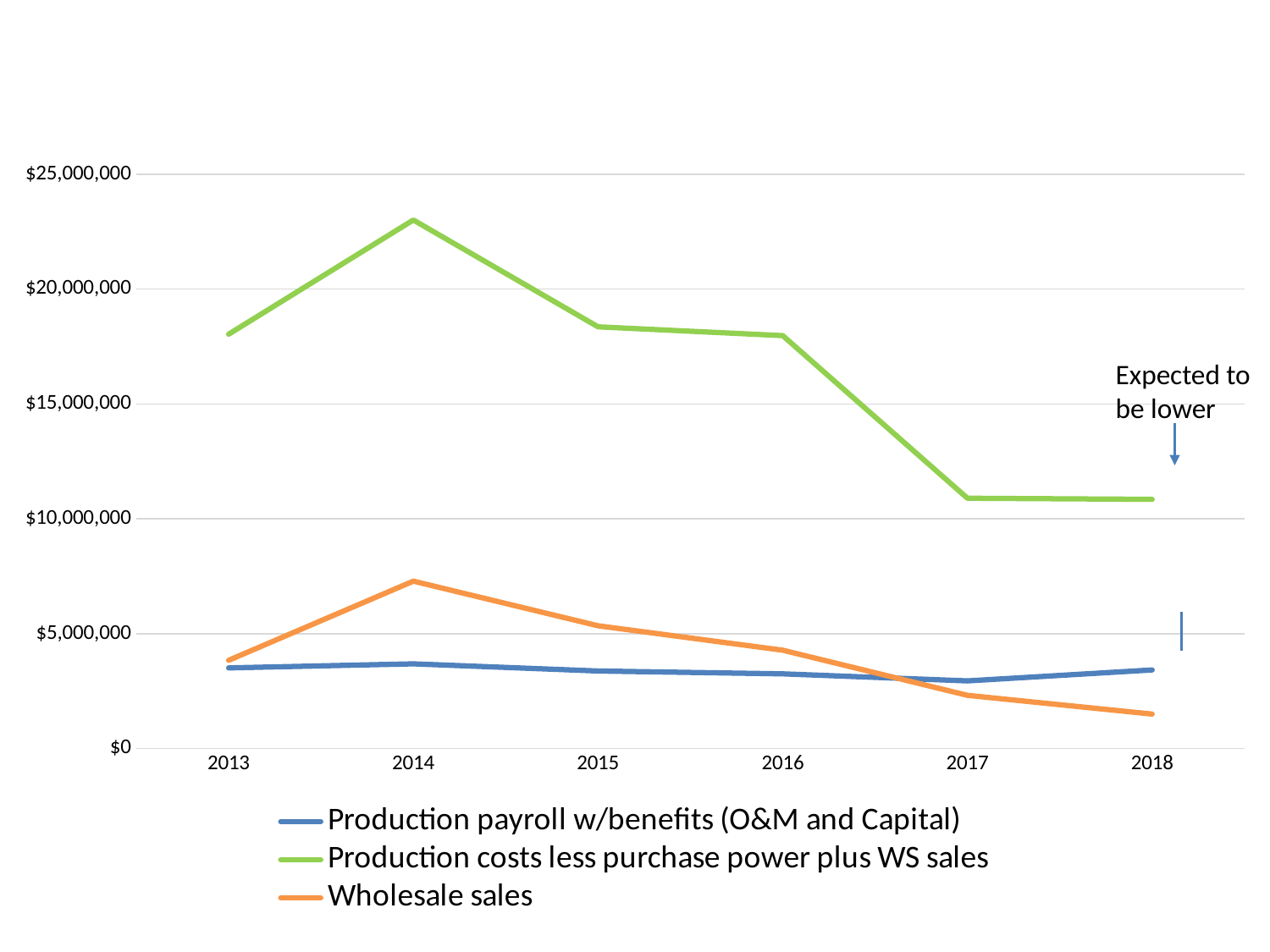
In which year is the 'Production costs less purchase power plus WS sales' line at its highest? 2014 Is the value for 'Production costs less purchase power plus WS sales' in 2014 greater or less than $20,000,000? greater Does the 'Production costs less purchase power plus WS sales' line rise or fall from 2014 to 2017? fall Is the value for 'Wholesale sales' in 2014 greater or less than $5,000,000? greater In 2018, which is larger: 'Production payroll w/benefits (O&M and Capital)' or 'Wholesale sales'? Production payroll w/benefits (O&M and Capital) What kind of chart is shown on the slide? line chart Is the value for 'Production costs less purchase power plus WS sales' in 2017 greater or less than $15,000,000? less How many years are plotted along the x axis? 6 In which year is the 'Wholesale sales' line at its lowest? 2018 In which year is the 'Wholesale sales' line at its highest? 2014 How many series does the legend list? 3